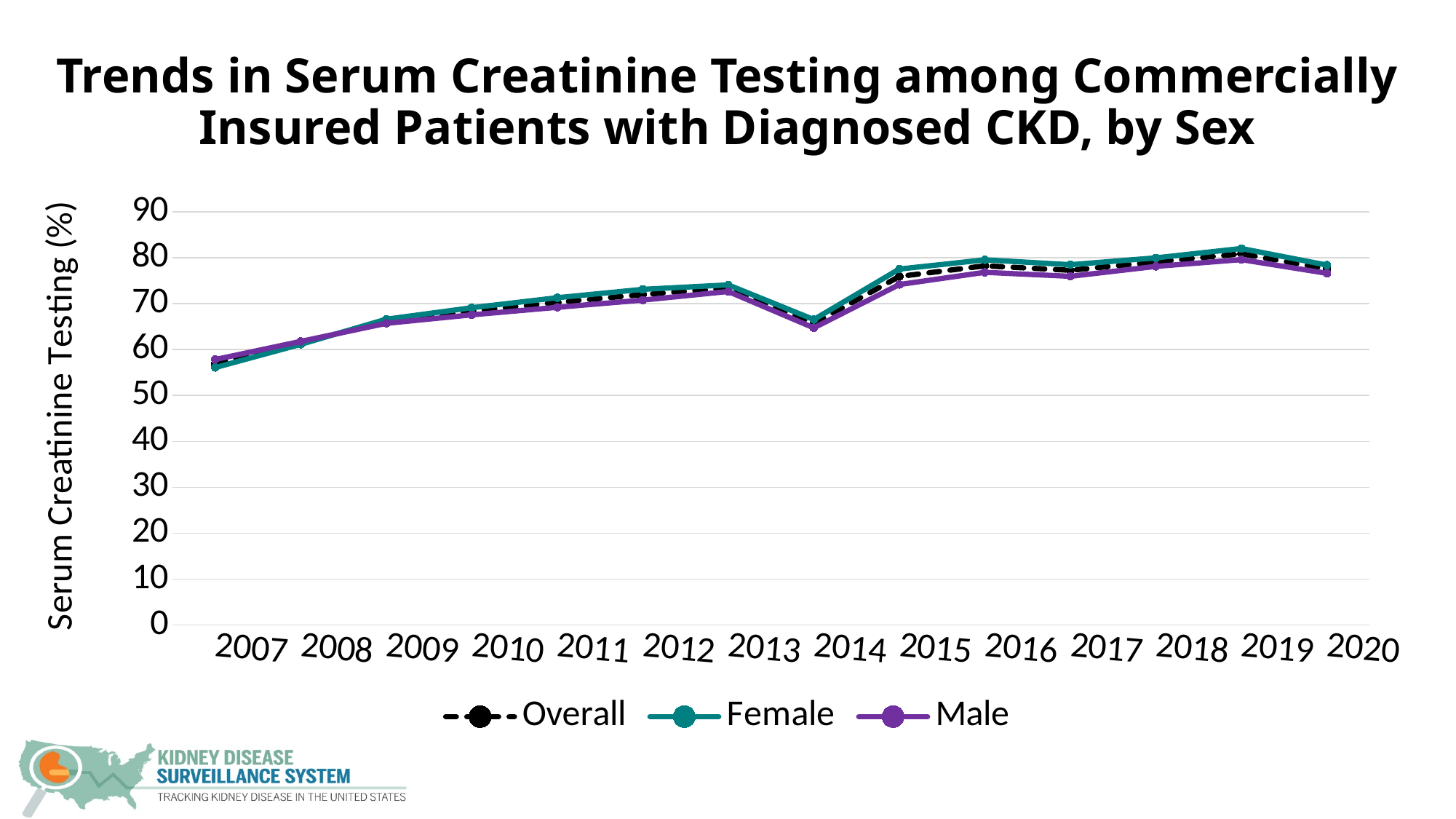
In 2015, which series has the larger value, Female or Male? Female Which series are listed in the legend? Overall, Female, Male What is the label of the y axis? Serum Creatinine Testing (%) Is the value for Male in 2019 greater or less than 70? greater What kind of chart is shown on the slide? line chart How many years are shown on the x axis? 14 In which year does the Female series reach its highest value? 2019 Is the value for Overall in 2014 greater or less than 70? less In which year is the Male series at its lowest value? 2007 How many series does the legend list? 3 Do the values for the Female series generally rise or fall from 2007 to 2020? rise Is the value for Female in 2007 greater or less than 60? less